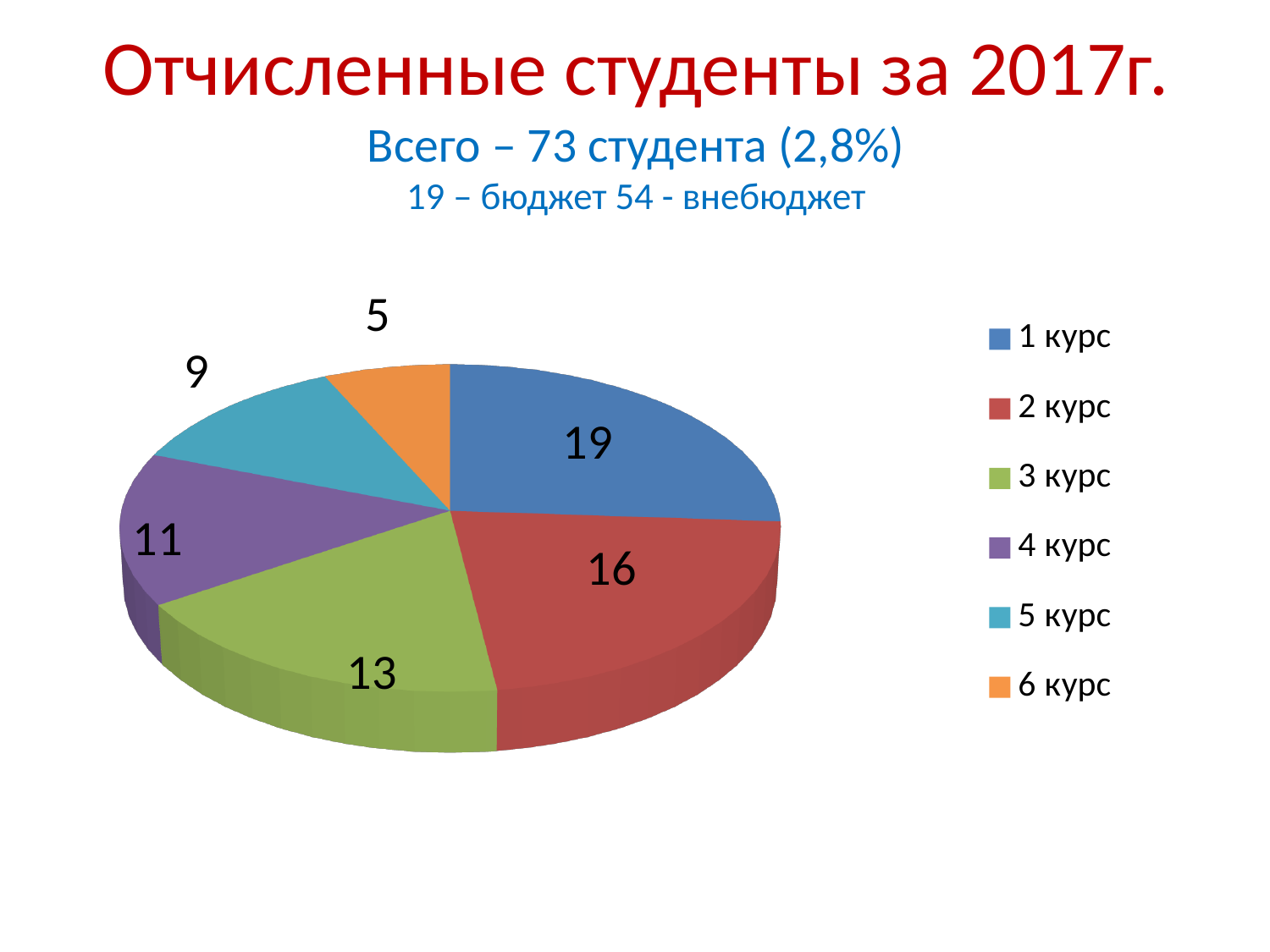
What is the value for 6 курс? 5 What is the value for 5 курс? 9 What is the value for 3 курс? 13 Which course has the smallest slice of the pie? 6 курс What is the difference between the values for 1 курс and 2 курс? 3 Which is larger, the value for 3 курс or the value for 5 курс? 3 курс How many students were expelled from 1 курс? 19 What is the difference between the values for 4 курс and 6 курс? 6 What type of chart is shown on the slide? pie chart What is the total of all slices in the pie chart? 73 Which course has the largest slice of the pie? 1 курс How many categories does the legend list? 6